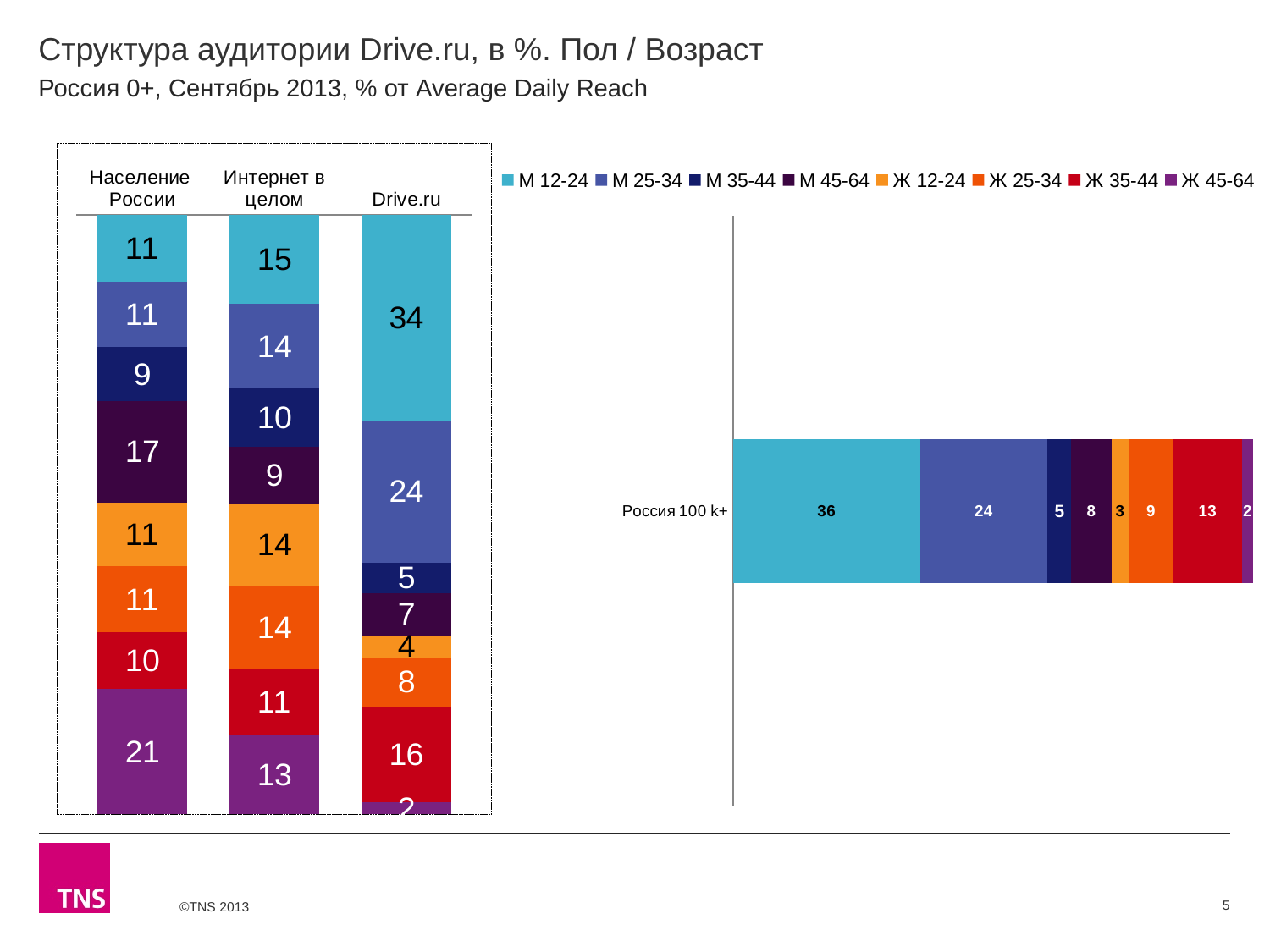
In the right chart, what is the value for Ж 35-44 for Россия 100 k+? 13 How many columns (categories) are shown in the left chart? 3 In the left chart, which is larger: Ж 35-44 for Drive.ru or Ж 35-44 for Население России? Drive.ru In the right chart, which segment is the smallest for Россия 100 k+? Ж 45-64 In the right chart, what is the value for М 12-24 for Россия 100 k+? 36 What type of chart is the right chart? Stacked bar chart In the left chart, what is the difference between the М 12-24 values for Drive.ru and Интернет в целом? 19 In the left chart, what is the value for М 35-44 in the Интернет в целом column? 10 In the left chart, what is the value for Ж 45-64 in the Население России column? 21 How many series does the legend list? 8 In the left chart, what is the value for М 12-24 in the Drive.ru column? 34 In the left chart, which segment is the largest in the Drive.ru column? М 12-24